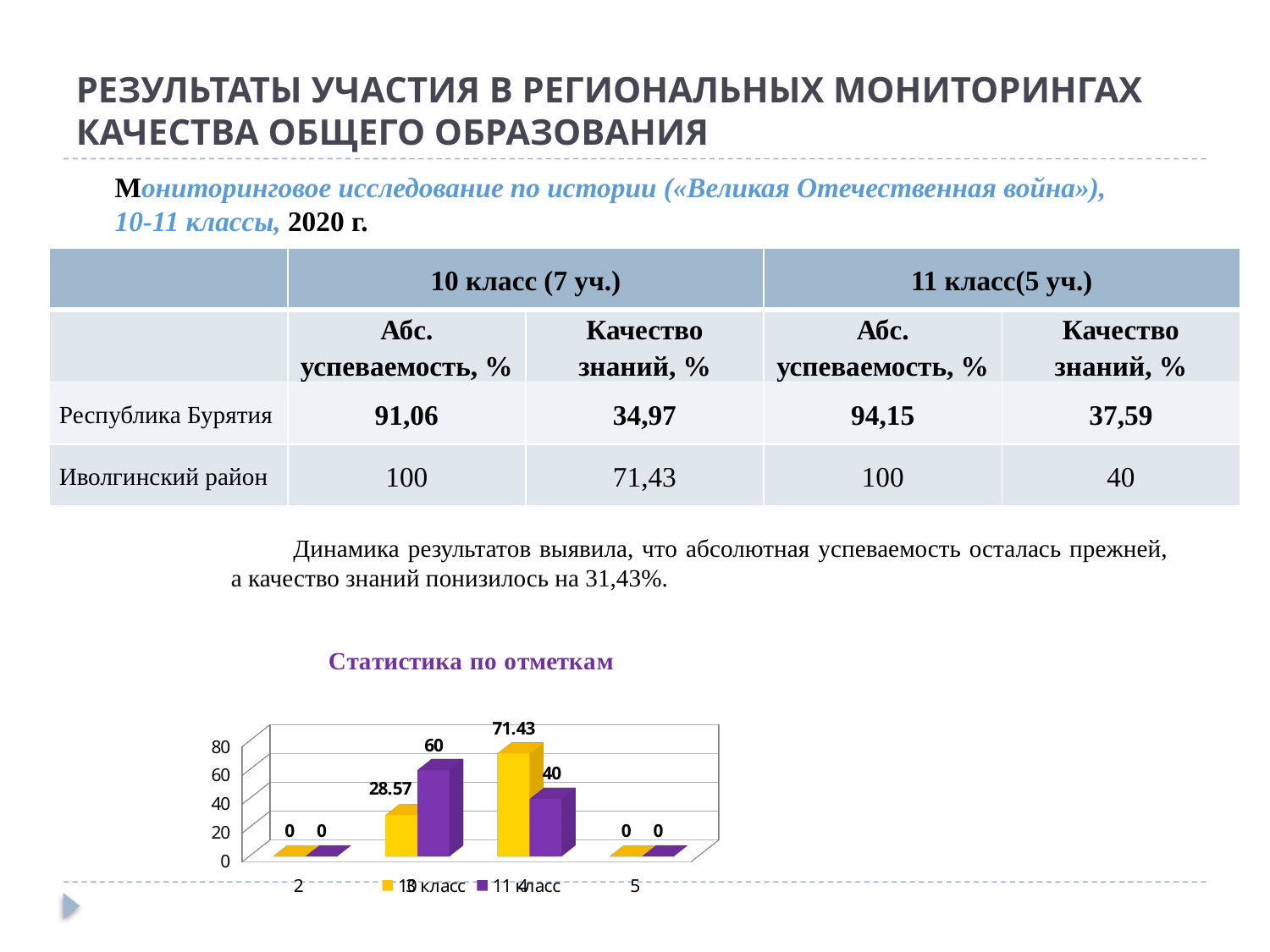
In the chart "Статистика по отметкам", is the value for 10 класс at grade 4 greater or less than 60? greater What is the value for 10 класс at grade 3 in the chart "Статистика по отметкам"? 28.57 What is the value for 11 класс at grade 4 in the chart "Статистика по отметкам"? 40 In the chart "Статистика по отметкам", which grade has the highest value for 11 класс? 3 How many grade categories are shown on the x axis of the chart "Статистика по отметкам"? 4 What is the value for 11 класс at grade 3 in the chart "Статистика по отметкам"? 60 In the chart "Статистика по отметкам", what is the difference between the 10 класс and 11 класс values at grade 4? 31.43 How many series does the legend of the chart "Статистика по отметкам" list? 2 In the chart "Статистика по отметкам", which grade has the highest value for 10 класс? 4 What is the value for 10 класс at grade 4 in the chart "Статистика по отметкам"? 71.43 What type of chart is "Статистика по отметкам"? bar chart In the chart "Статистика по отметкам", which series has the larger value at grade 3, 10 класс or 11 класс? 11 класс